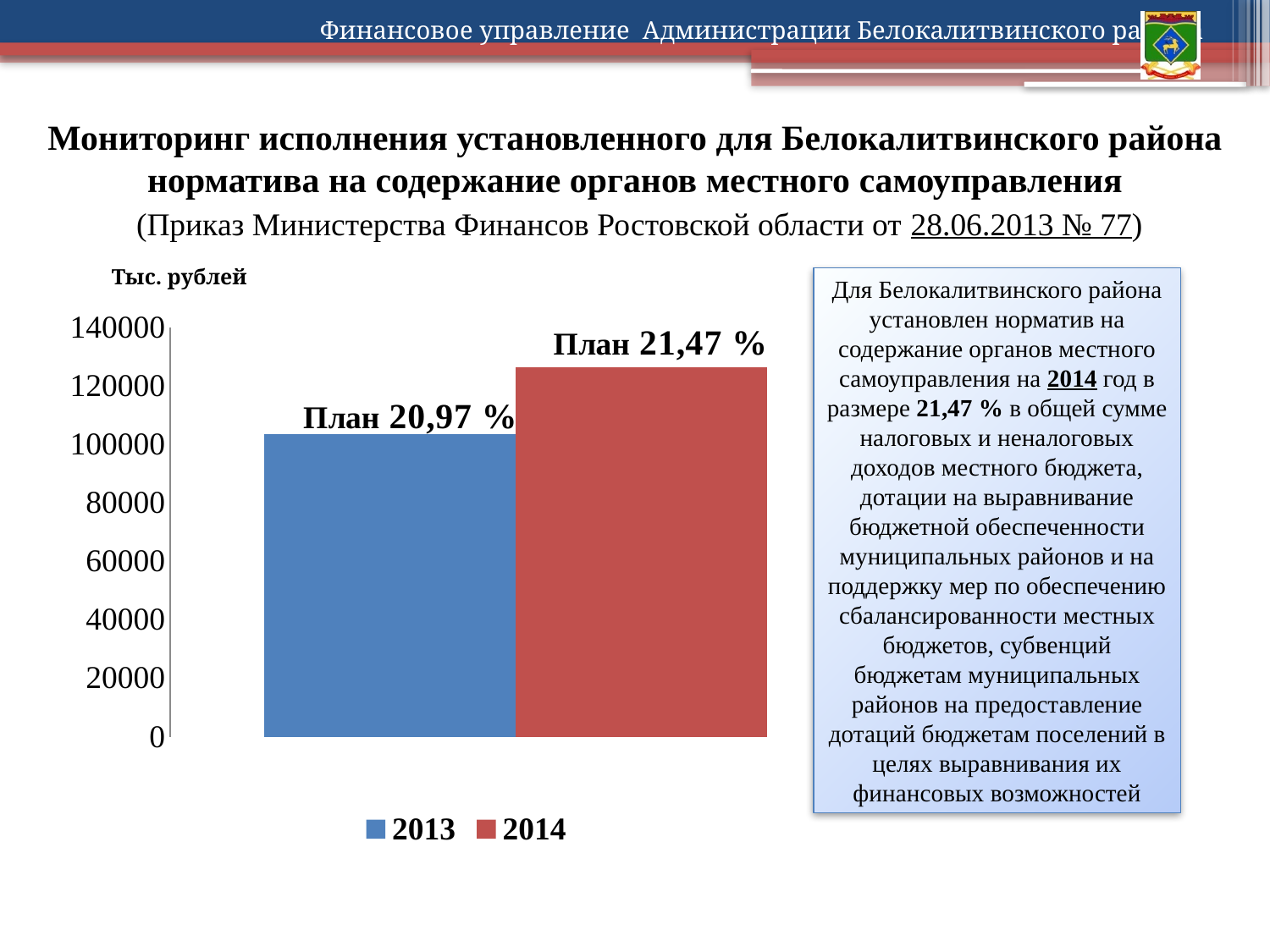
What kind of chart is shown on the slide? bar chart Is the bar for 2014 larger or smaller than the bar for 2013? larger Which year has the taller bar in the chart? 2014 What unit is indicated above the vertical axis of the chart? Тыс. рублей How many bars are plotted in the chart? 2 What data label is printed above the 2013 bar? План 20,97 % How many series does the chart legend list? 2 What data label is printed above the 2014 bar? План 21,47 % Is the value for 2014 greater or less than 120000? greater Do the bar values rise or fall from 2013 to 2014? rise Is the value for 2013 greater or less than 120000? less Which year has the shorter bar in the chart? 2013